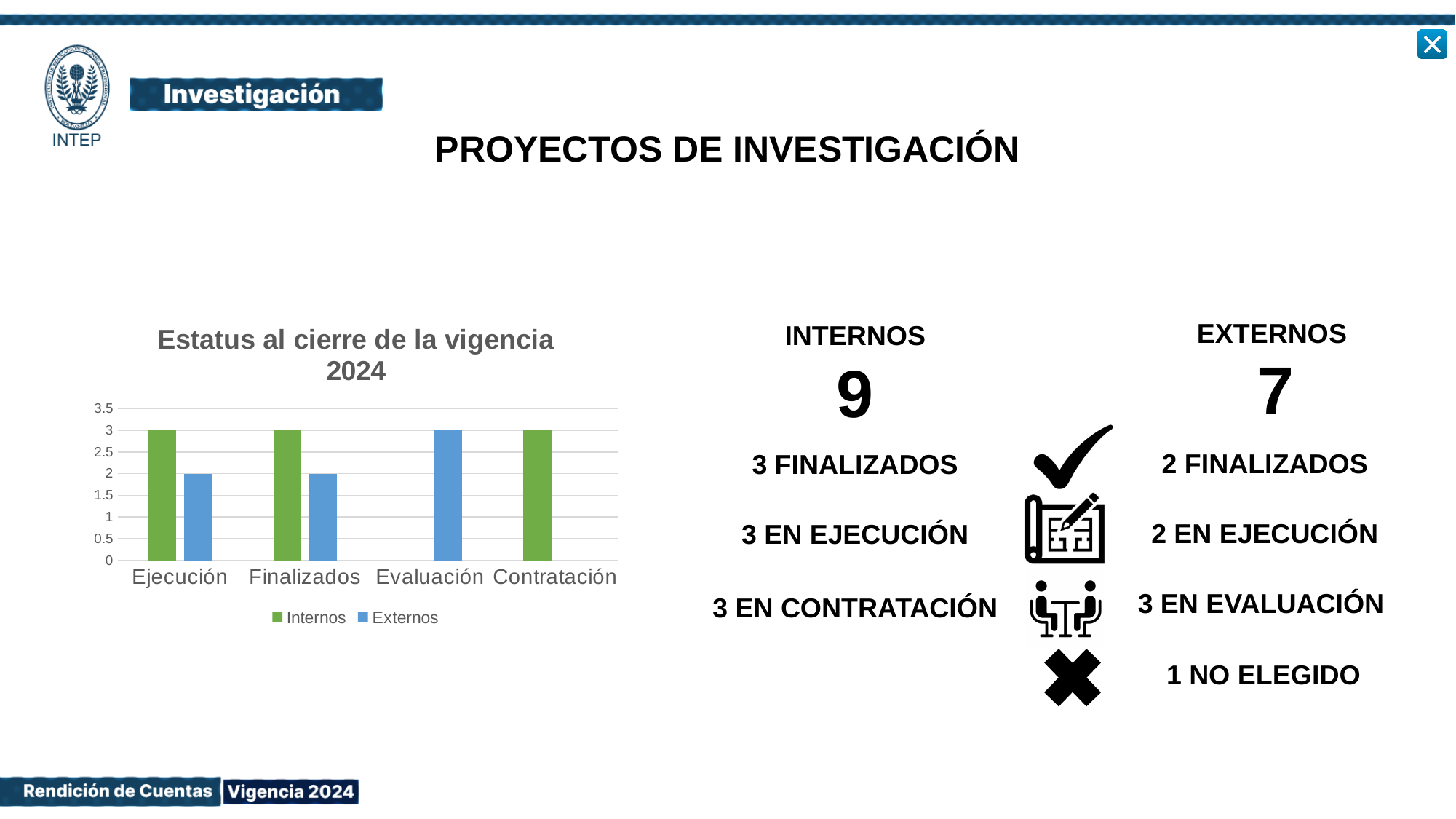
What is the difference between Internos and Externos in the Finalizados category? 1 Which category has the lowest value for Externos? Contratación How many categories are shown on the x axis of the chart? 4 What is the title of the chart? Estatus al cierre de la vigencia 2024 What is the value for Internos in the Ejecución category? 3 What is the value for Externos in the Evaluación category? 3 What is the value for Externos in the Ejecución category? 2 What type of chart is shown on the slide? Bar chart What is the value for Internos in the Contratación category? 3 Which is larger in the Finalizados category, Internos or Externos? Internos Which colour represents the Externos series in the chart? Blue How many series does the chart legend list? 2